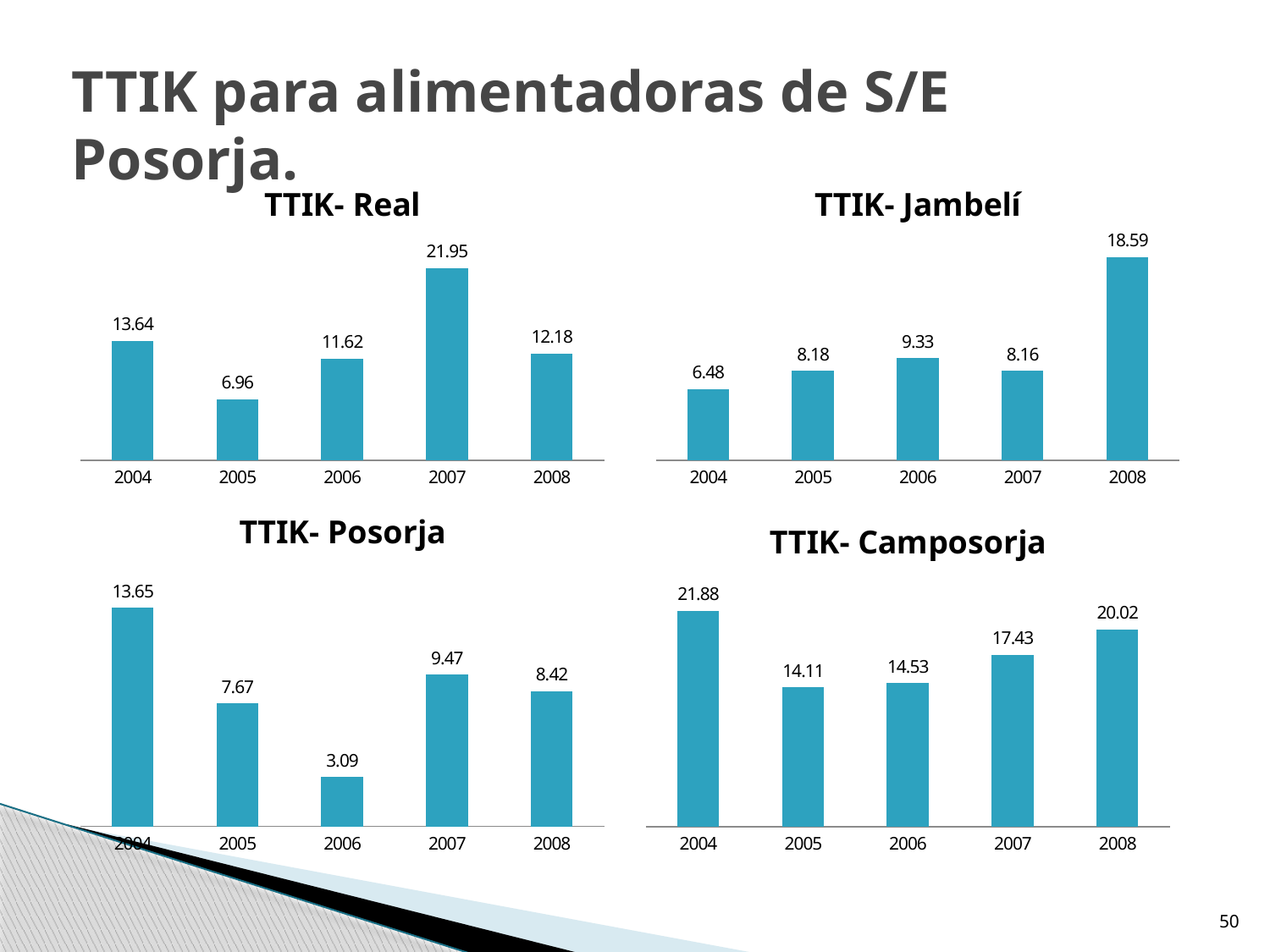
In the TTIK- Real chart, what is the value for 2007? 21.95 In the TTIK- Camposorja chart, what is the value for 2005? 14.11 How many bars are in the TTIK- Jambelí chart? 5 In the TTIK- Jambelí chart, what is the value for 2007? 8.16 What type of chart is the TTIK- Posorja chart? Bar chart In the TTIK- Camposorja chart, what is the difference between the values for 2008 and 2007? 2.59 In the TTIK- Posorja chart, what is the value for 2004? 13.65 In the TTIK- Real chart, what is the difference between the values for 2007 and 2005? 14.99 In the TTIK- Jambelí chart, which year has the highest value? 2008 How many charts are shown on the slide? 4 In the TTIK- Jambelí chart, which is larger, the value for 2006 or the value for 2004? 2006 In the TTIK- Posorja chart, which year has the lowest value? 2006